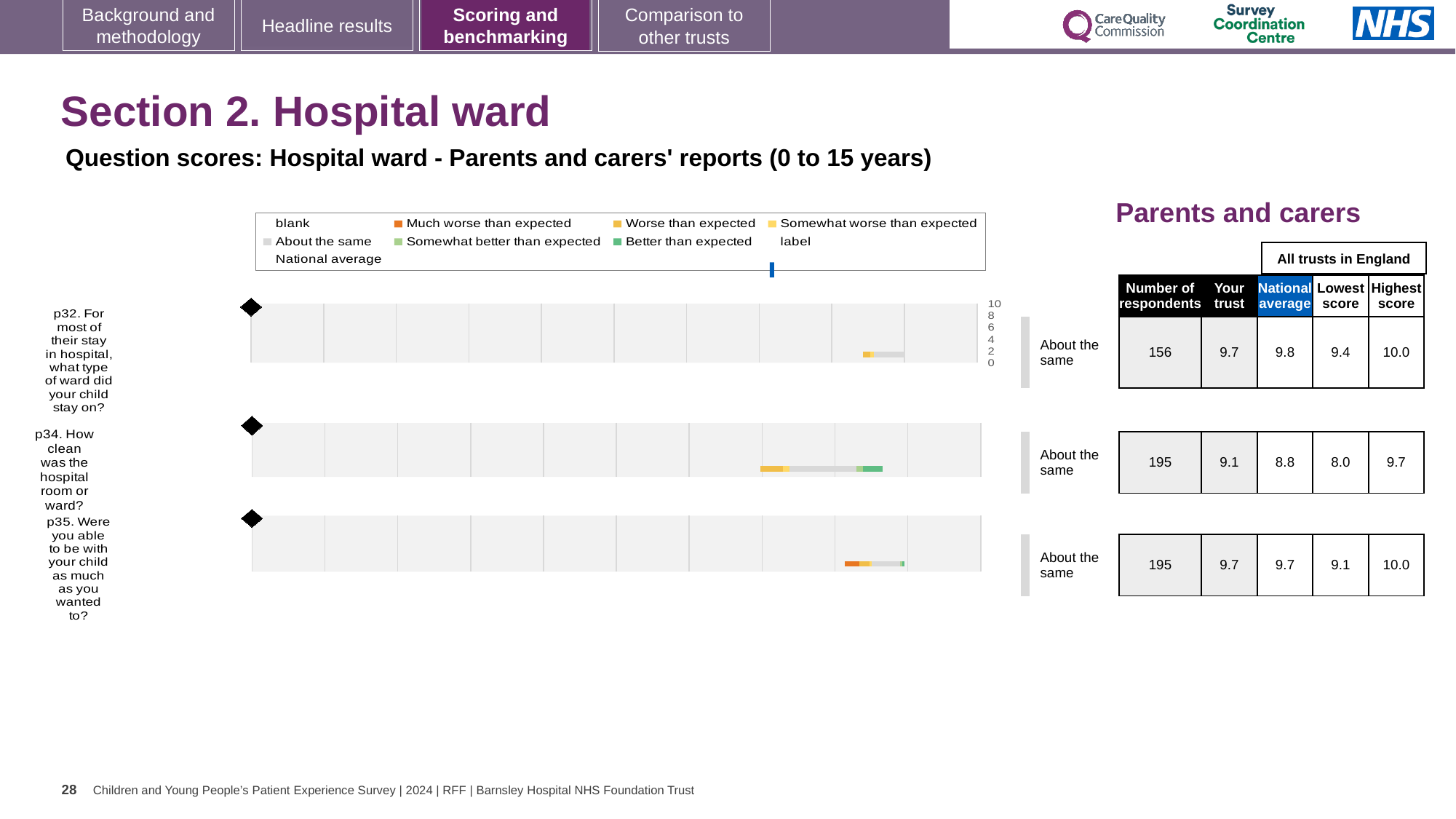
Which question has the lowest 'Your trust' score? p34 How many respondents answered p32? 156 What benchmark category label is shown next to each of the three questions? About the same What is the national average score for p32 (For most of their stay in hospital, what type of ward did your child stay on?)? 9.8 What is the lowest score among all trusts in England for p35 (Were you able to be with your child as much as you wanted to?)? 9.1 Which question has the lowest national average score? p34 What is the difference between the national average and the 'Your trust' score for p32? 0.1 What is the difference between the highest score and the lowest score for p34? 1.7 What is the 'Your trust' score for p34 (How clean was the hospital room or ward?)? 9.1 What is the highest score among all trusts in England for p34? 9.7 For p34, which is larger: the 'Your trust' score or the national average? Your trust How many questions are plotted on this slide? 3